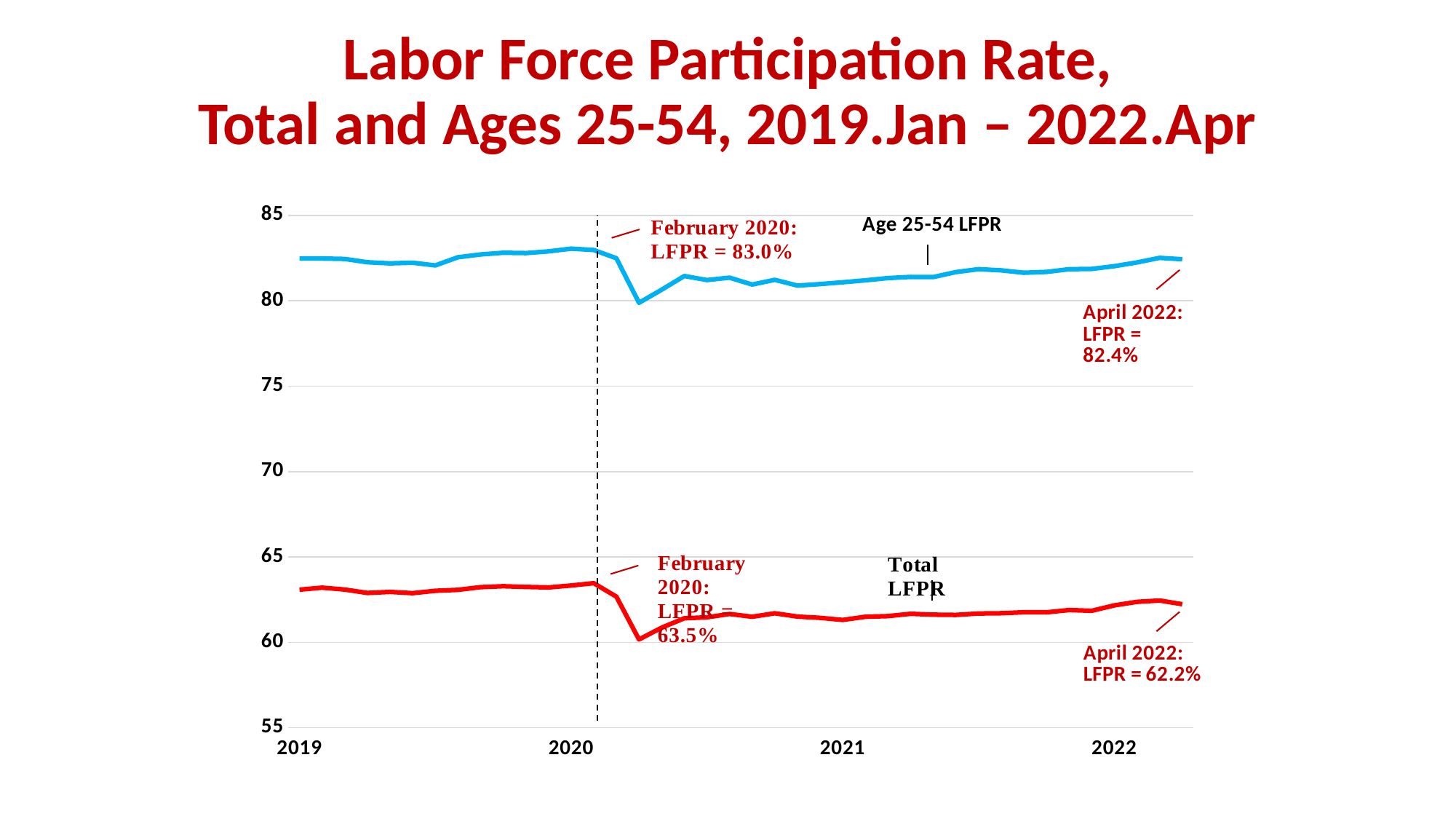
What was the Age 25-54 LFPR in February 2020, according to the annotation? 83.0% Which series has the higher values throughout the chart, Age 25-54 LFPR or Total LFPR? Age 25-54 LFPR Was the Total LFPR in February 2020 higher or lower than in April 2022? higher What was the Total LFPR in April 2022, according to the annotation? 62.2% Is the Age 25-54 LFPR at the start of 2019 greater or less than 80? greater What colour is the line for Total LFPR? red By how many percentage points did the Age 25-54 LFPR in April 2022 differ from its February 2020 value? 0.6 By how many percentage points did the Total LFPR in April 2022 differ from its February 2020 value? 1.3 What was the Age 25-54 LFPR in April 2022, according to the annotation? 82.4% What was the Total LFPR in February 2020, according to the annotation? 63.5% What type of chart is shown on the slide? line chart How many data series are plotted on the chart? 2